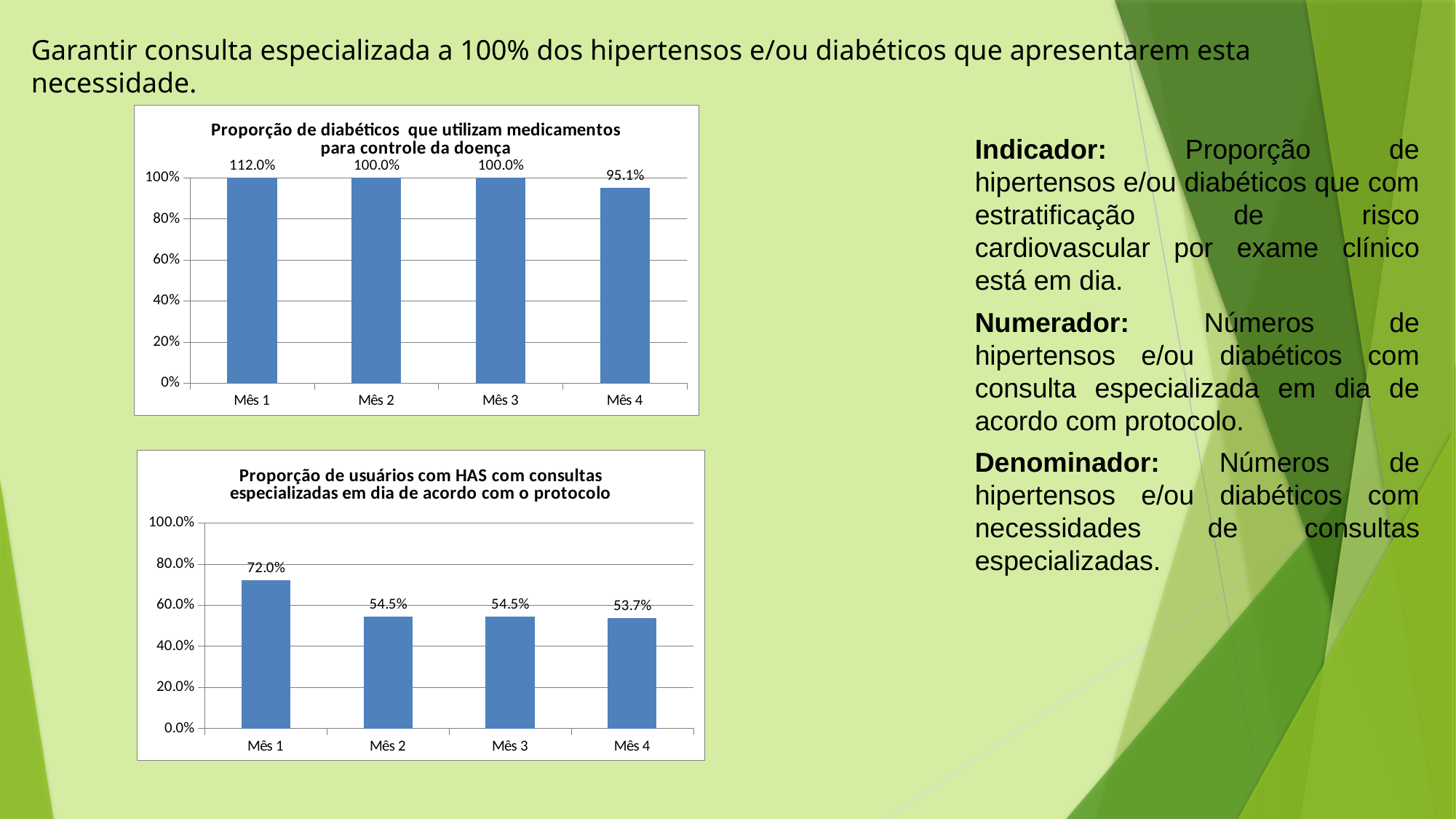
In the bottom chart (Proporção de usuários com HAS com consultas especializadas em dia de acordo com o protocolo), what is the value for Mês 4? 53.7% In the bottom chart (Proporção de usuários com HAS com consultas especializadas em dia de acordo com o protocolo), what is the difference between the values for Mês 1 and Mês 2? 17.5% In the bottom chart (Proporção de usuários com HAS com consultas especializadas em dia de acordo com o protocolo), is the value for Mês 1 greater or less than 60.0%? greater What kind of chart is the bottom chart (Proporção de usuários com HAS com consultas especializadas em dia de acordo com o protocolo)? bar chart In the bottom chart (Proporção de usuários com HAS com consultas especializadas em dia de acordo com o protocolo), what is the value for Mês 1? 72.0% In the top chart (Proporção de diabéticos que utilizam medicamentos para controle da doença), how many months are shown on the x axis? 4 In the top chart (Proporção de diabéticos que utilizam medicamentos para controle da doença), which month has the lowest value? Mês 4 In the top chart (Proporção de diabéticos que utilizam medicamentos para controle da doença), what is the value for Mês 1? 112.0% In the top chart (Proporção de diabéticos que utilizam medicamentos para controle da doença), what is the difference between the values for Mês 1 and Mês 4? 16.9% In the bottom chart (Proporção de usuários com HAS com consultas especializadas em dia de acordo com o protocolo), which month has the highest value? Mês 1 In the bottom chart (Proporção de usuários com HAS com consultas especializadas em dia de acordo com o protocolo), do the values rise or fall from Mês 1 to Mês 4? fall In the top chart (Proporção de diabéticos que utilizam medicamentos para controle da doença), what is the value for Mês 4? 95.1%